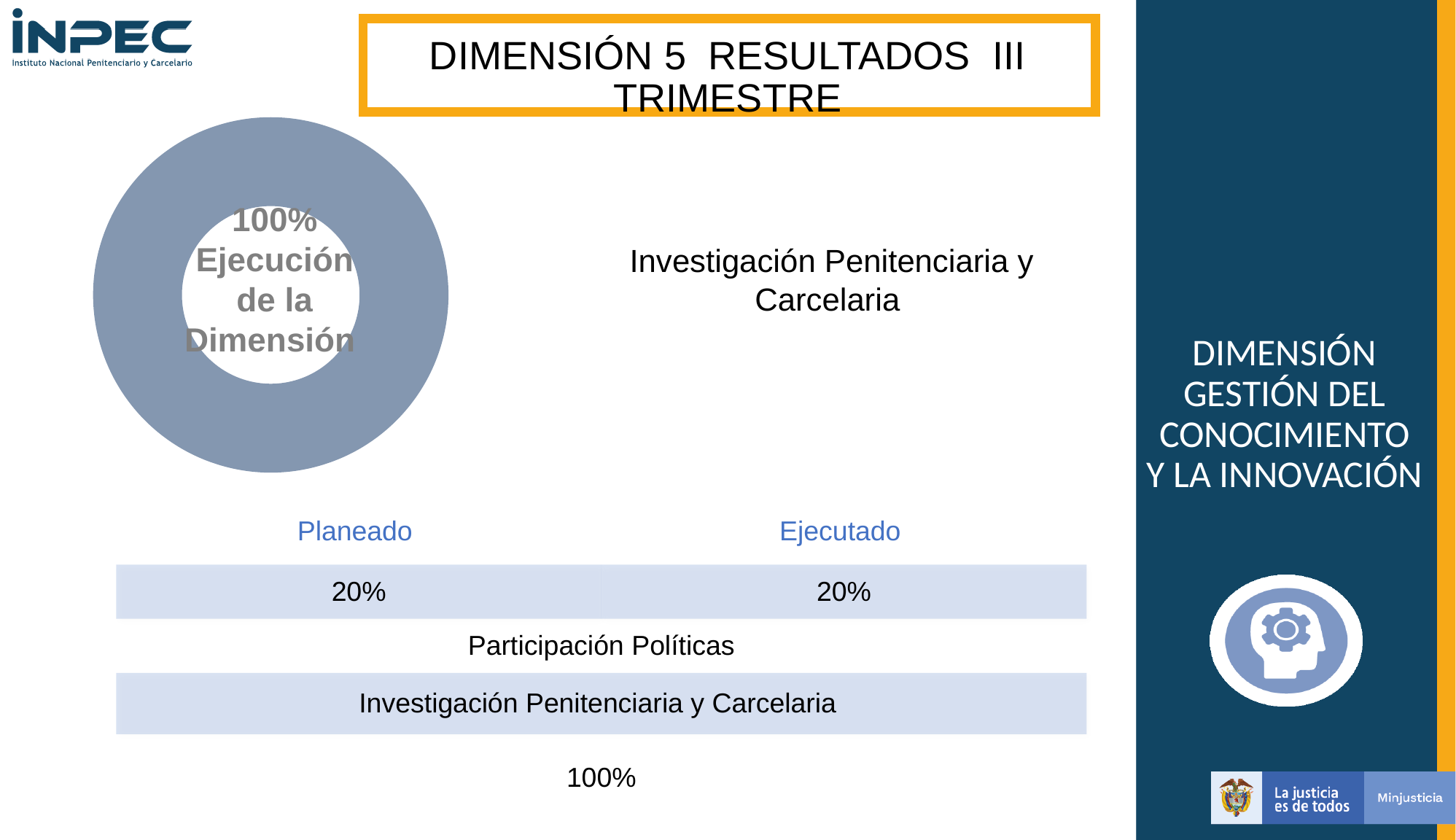
Is the value shown in the doughnut chart greater or less than 50%? greater What share of the doughnut chart does the single slice occupy? 100% What text accompanies the 100% value in the centre of the doughnut chart? Ejecución de la Dimensión What kind of chart is shown on the left of the slide? doughnut chart What percentage is printed in the centre of the doughnut chart? 100% How many slices does the doughnut chart contain? 1 What is the title of the slide containing the doughnut chart? DIMENSIÓN 5 RESULTADOS III TRIMESTRE